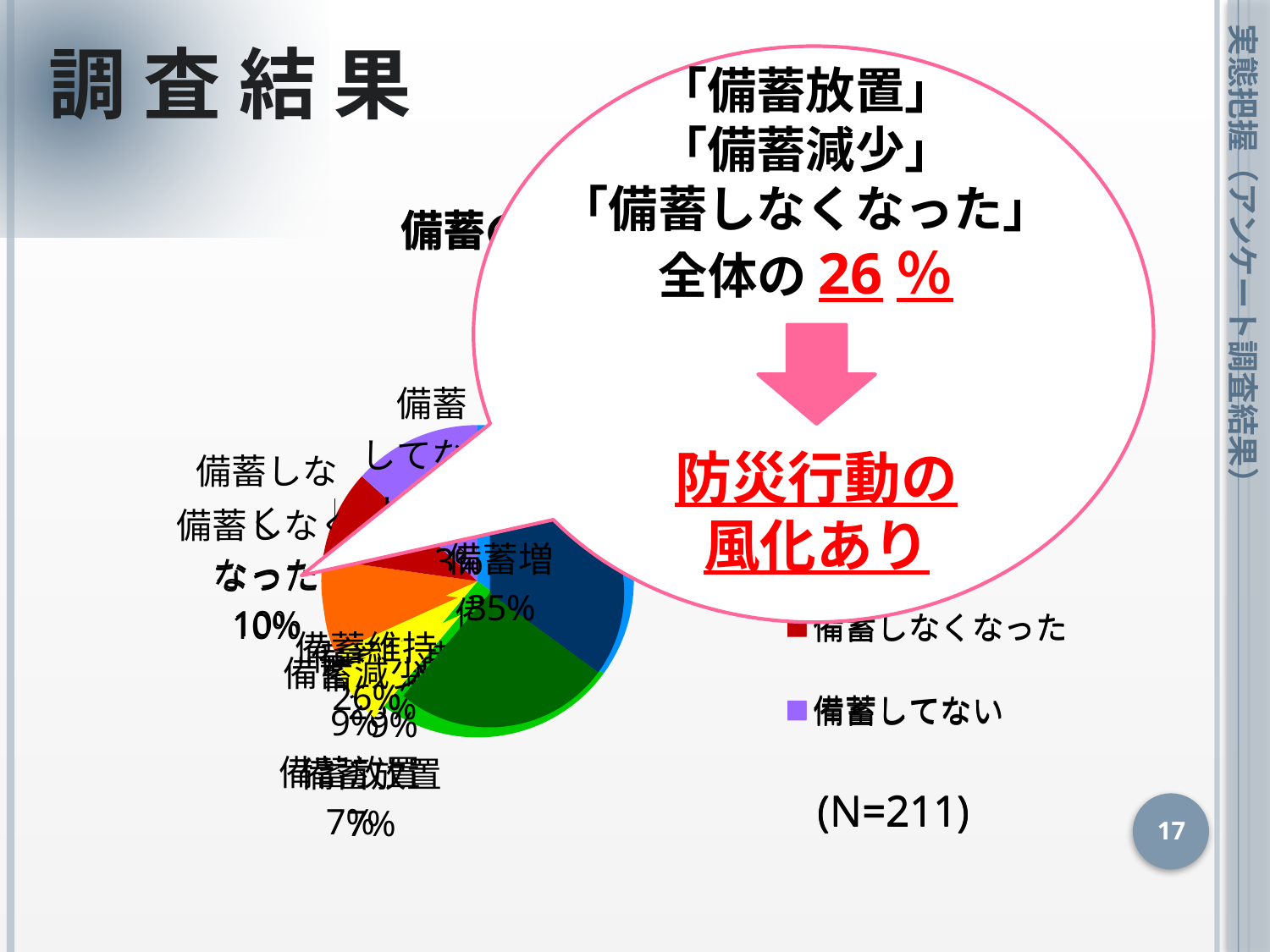
Which colour represents 備蓄してない in the legend? purple Which colour represents 備蓄しなくなった in the legend? dark red Is the share for 備蓄しなくなった greater or less than 20%? less What percentage is shown for 備蓄しなくなった in the pie chart? 10% What kind of chart is shown on the slide? pie chart